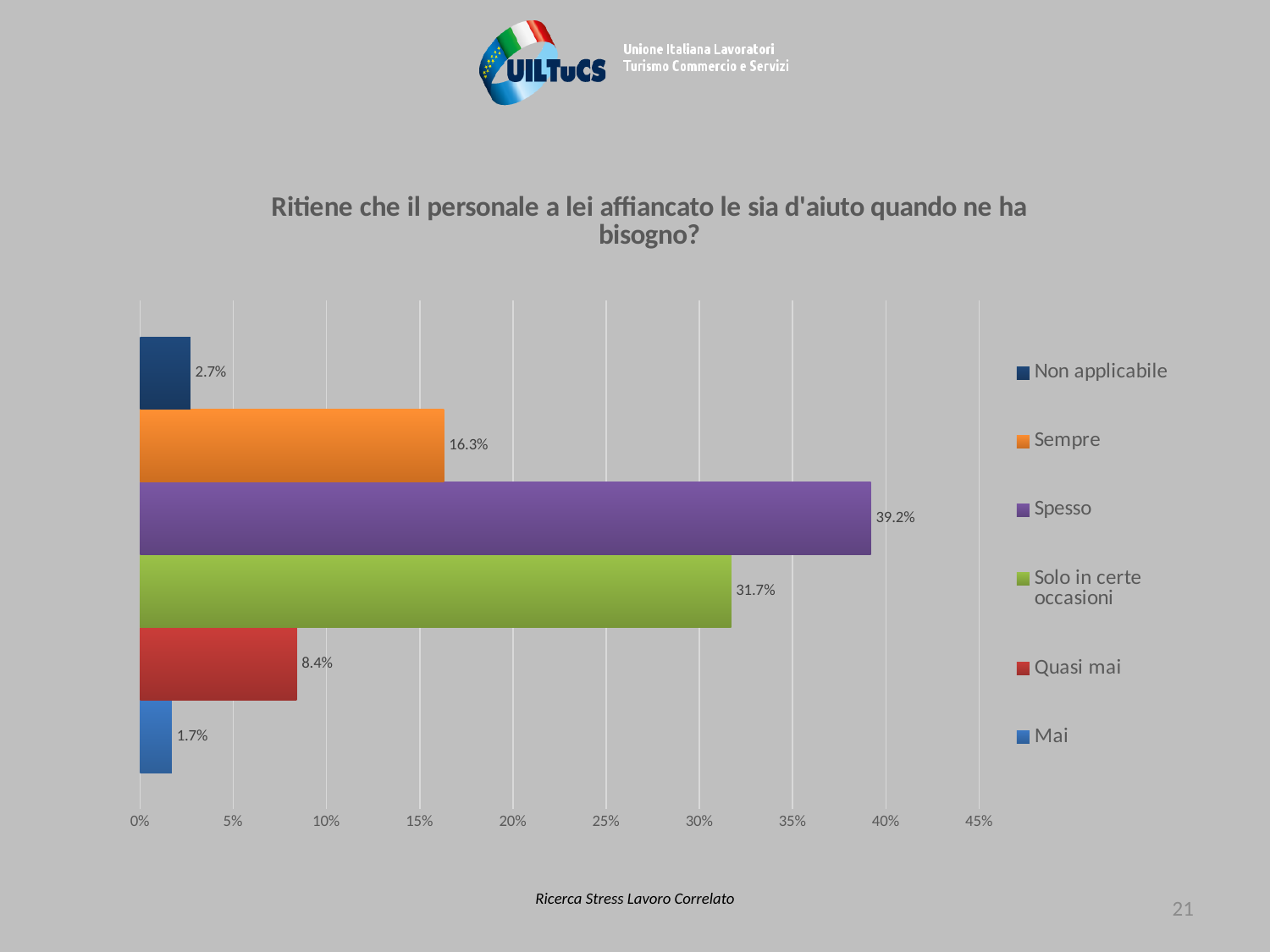
What is the difference between the values for Spesso and Solo in certe occasioni? 7.5% Which is larger, the value for Sempre or the value for Quasi mai? Sempre What kind of chart is shown on the slide? bar chart Which category has the lowest value? Mai What is the value for Mai? 1.7% How many categories are shown in the chart? 6 What is the value for Quasi mai? 8.4% What is the value for Spesso? 39.2% Is the value for Solo in certe occasioni greater or less than 30%? greater Which category has the highest value? Spesso What is the value for Sempre? 16.3% What colour is the bar for Non applicabile? dark blue